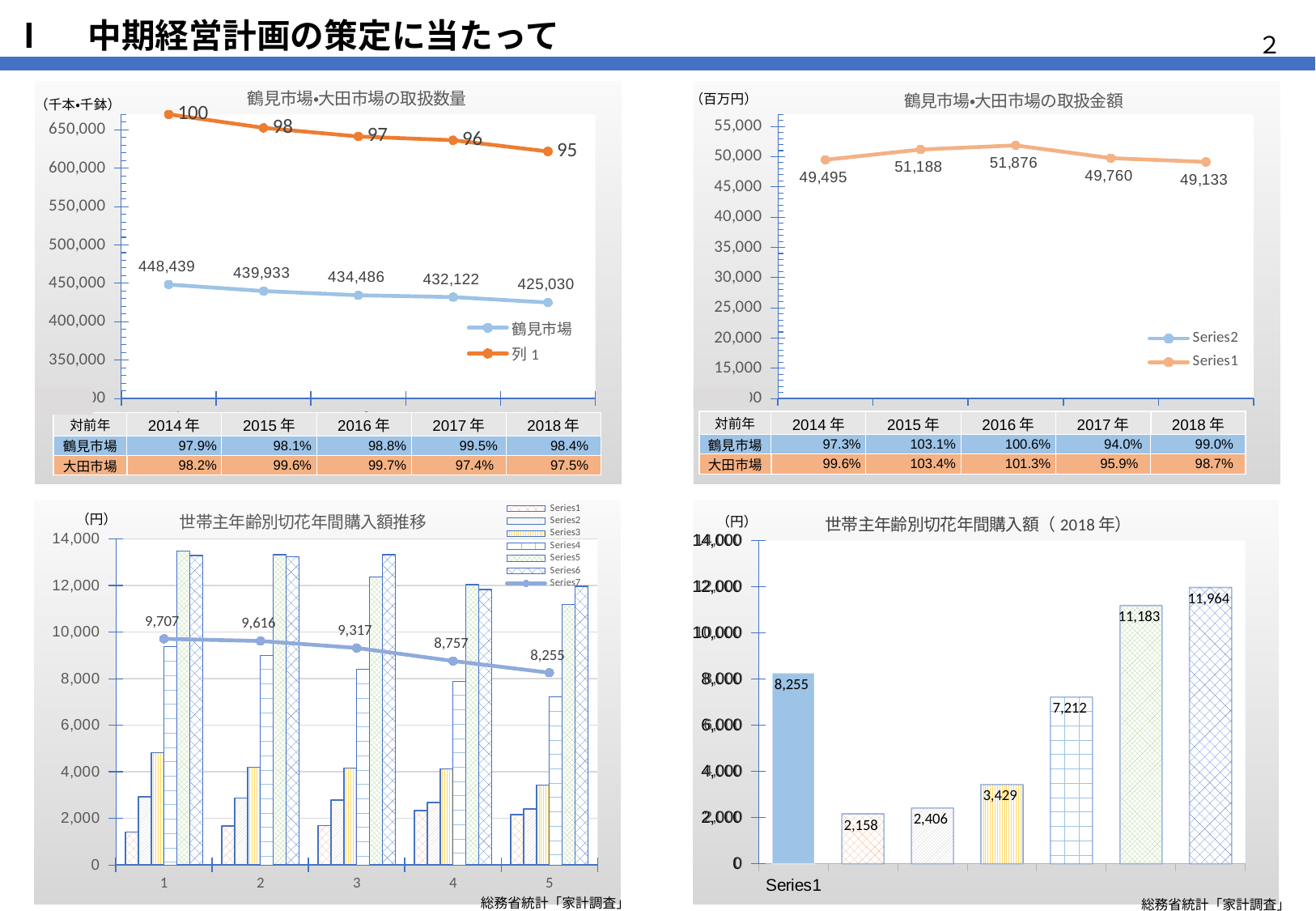
How many bars are plotted in the bottom-right chart titled 世帯主年齢別切花年間購入額（2018年）? 7 In the bottom-left chart titled 世帯主年齢別切花年間購入額推移, what is the value of the line (Series7) at category 3? 9,317 In the top-left chart titled 鶴見市場•大田市場の取扱数量, do the 鶴見市場 values rise or fall from left to right? fall In the top-right chart titled 鶴見市場•大田市場の取扱金額, what is the highest value shown on the line? 51,876 In the top-left chart titled 鶴見市場•大田市場の取扱数量, what is the value of the 鶴見市場 series at the leftmost point (2014年)? 448,439 In the top-right chart titled 鶴見市場•大田市場の取扱金額, what is the lowest value shown on the line? 49,133 How many series does the legend of the top-left chart titled 鶴見市場•大田市場の取扱数量 list? 2 How many series does the legend of the bottom-left chart titled 世帯主年齢別切花年間購入額推移 list? 7 In the top-left chart titled 鶴見市場•大田市場の取扱数量, what is the difference between the first (448,439) and last (425,030) values of the 鶴見市場 series? 23,409 In the bottom-right chart titled 世帯主年齢別切花年間購入額（2018年）, what is the value of the tallest bar? 11,964 In the top-left chart titled 鶴見市場•大田市場の取扱数量, what is the lowest value shown for the 鶴見市場 series? 425,030 What kind of chart is the top-right chart titled 鶴見市場•大田市場の取扱金額? line chart